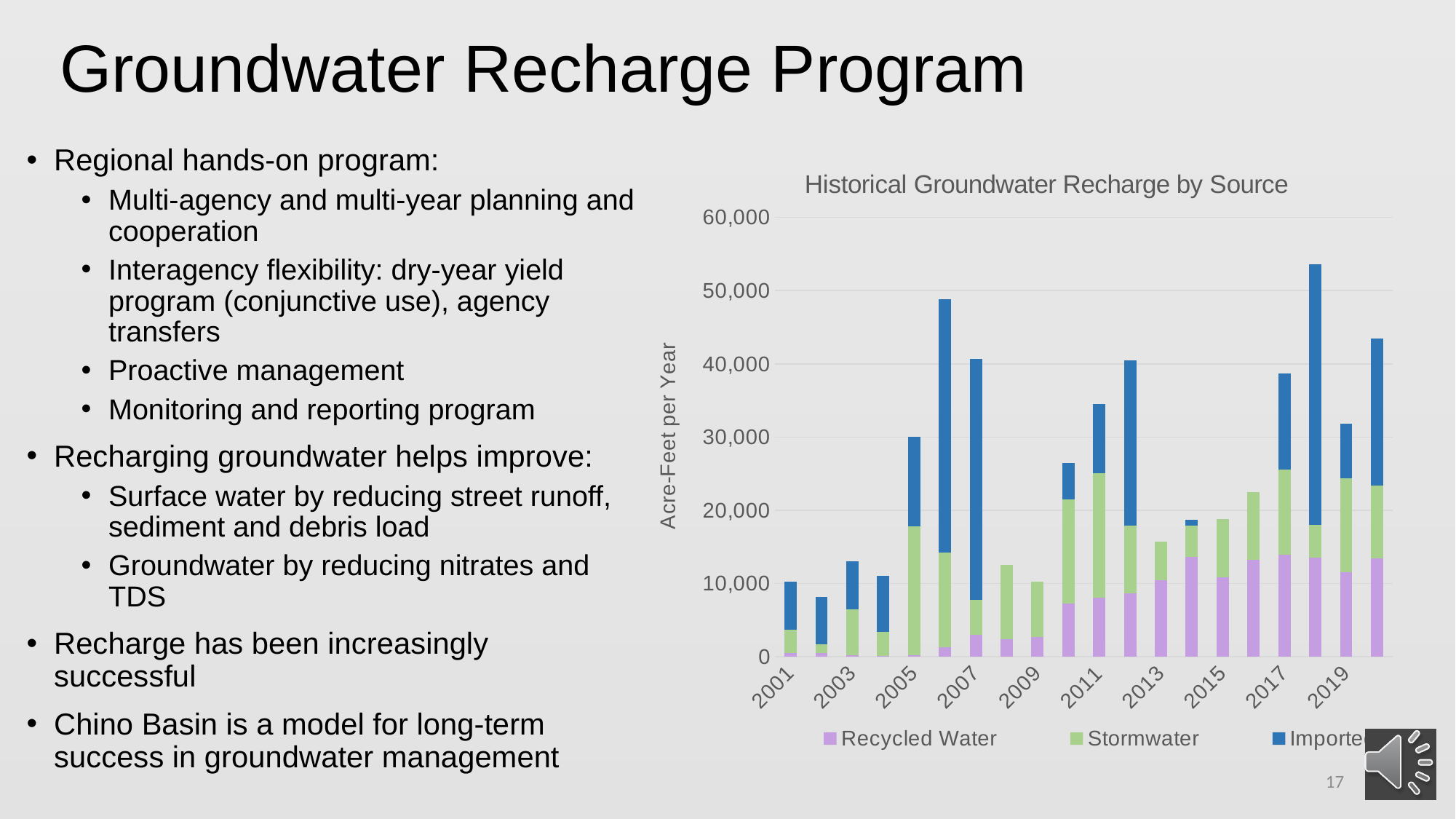
Is the total recharge for 2006 greater or less than 40,000? greater Which year has the lowest total groundwater recharge? 2002 What is the label on the vertical axis of the chart? Acre-Feet per Year How many yearly bars are plotted in the chart? 20 Is the total recharge for 2009 greater or less than 20,000? less Which year has the highest total groundwater recharge? 2018 Is the total recharge for 2018 greater or less than 50,000? greater How many series does the chart's legend list? 3 Which year has the larger total recharge, 2006 or 2007? 2006 What is the title of the chart? Historical Groundwater Recharge by Source What type of chart is shown on the slide? Stacked bar chart Which year has the larger total recharge, 2017 or 2019? 2017